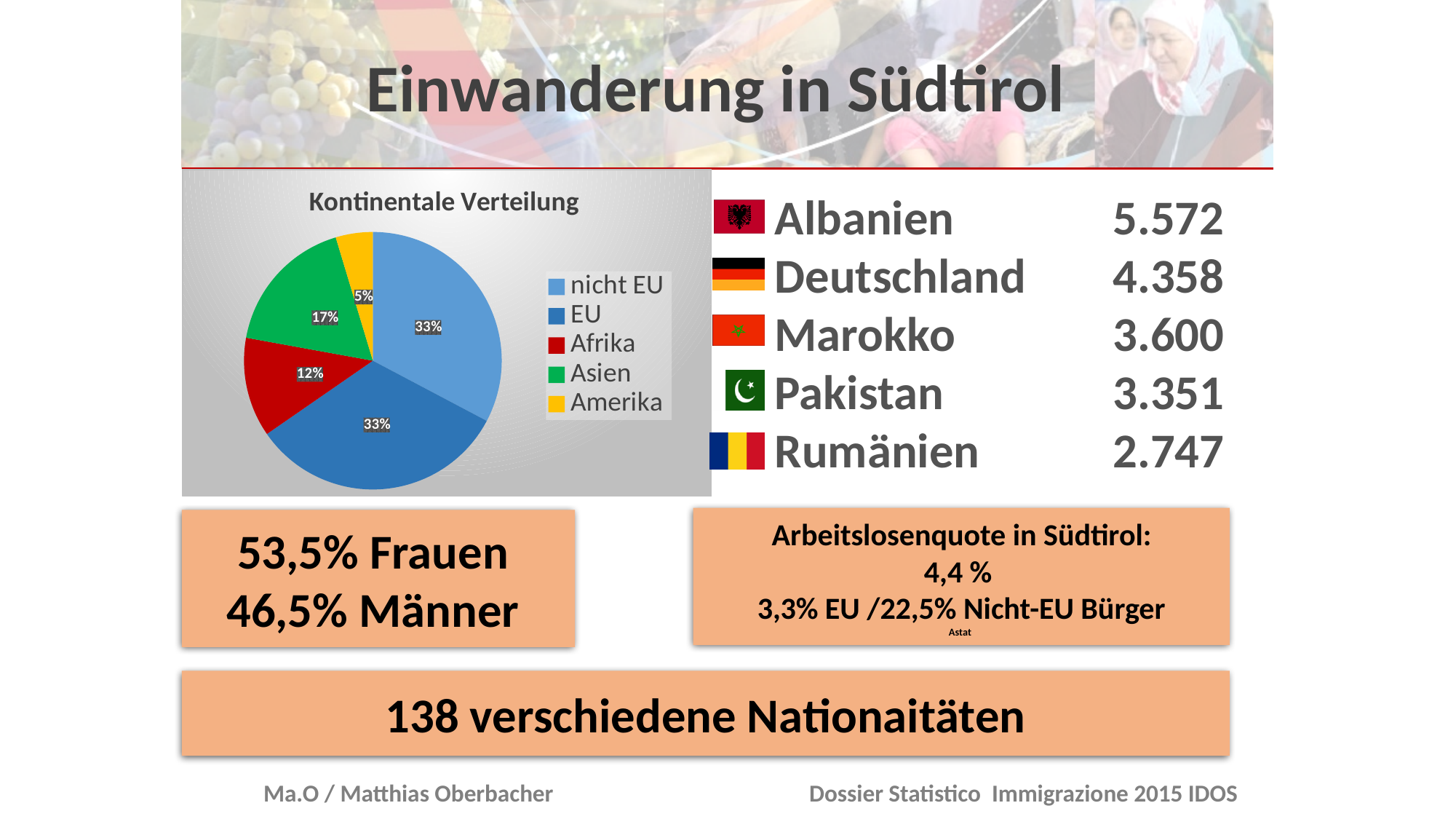
What share of the pie does Asien have? 17% What kind of chart is shown on the slide? pie chart What share of the pie does Amerika have? 5% Which colour represents Afrika in the pie chart? red Which category has the smallest slice of the pie? Amerika What share of the pie does Afrika have? 12% How many entries does the chart's legend list? 5 How many slices does the pie chart have? 5 What is the difference in percentage points between the Asien slice and the Amerika slice? 12 Which is larger, the slice for Asien or the slice for Afrika? Asien What is the title of the chart? Kontinentale Verteilung